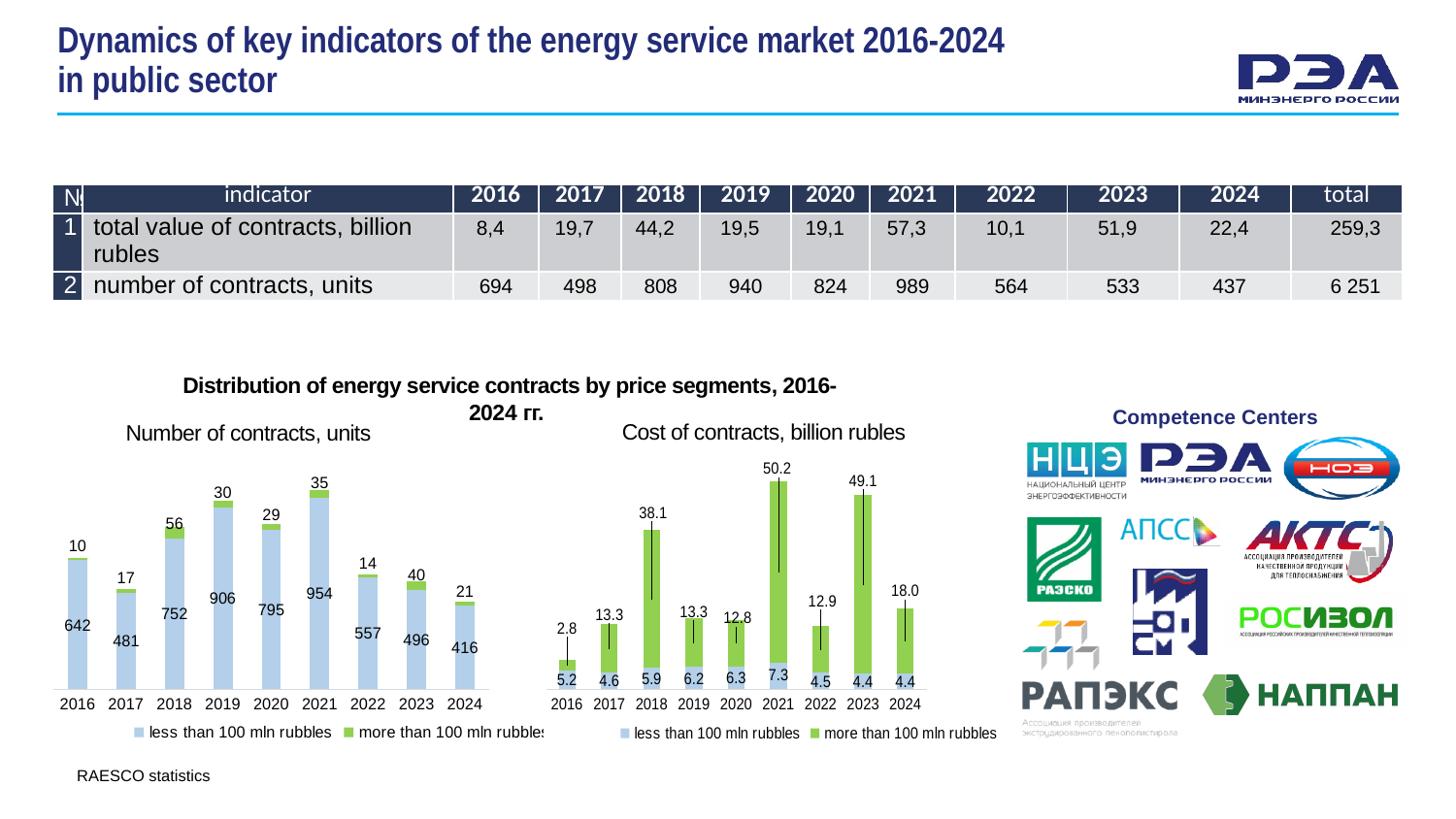
How many series does the legend of the 'Cost of contracts, billion rubles' chart list? 2 In the 'Cost of contracts, billion rubles' chart, which year has the lowest value for 'more than 100 mln rubbles'? 2016 In the 'Cost of contracts, billion rubles' chart, what is the value for 'more than 100 mln rubbles' in 2021? 50.2 In the 'Number of contracts, units' chart, what is the value for 'more than 100 mln rubbles' in 2018? 56 In the 'Number of contracts, units' chart, what is the value for 'less than 100 mln rubbles' in 2021? 954 In the 'Number of contracts, units' chart, what is the total of the stacked bar for 2021? 989 How many years are shown on the x axis of the 'Number of contracts, units' chart? 9 In the 'Cost of contracts, billion rubles' chart, what is the value for 'less than 100 mln rubbles' in 2024? 4.4 In the 'Number of contracts, units' chart, which year has the highest value for 'less than 100 mln rubbles'? 2021 In the 'Number of contracts, units' chart, what is the difference between the 'less than 100 mln rubbles' values for 2019 and 2020? 111 In the 'Cost of contracts, billion rubles' chart, what is the total of the stacked bar for 2024? 22.4 In the 'Cost of contracts, billion rubles' chart, which is larger: the 'more than 100 mln rubbles' value for 2018 or for 2023? 2023